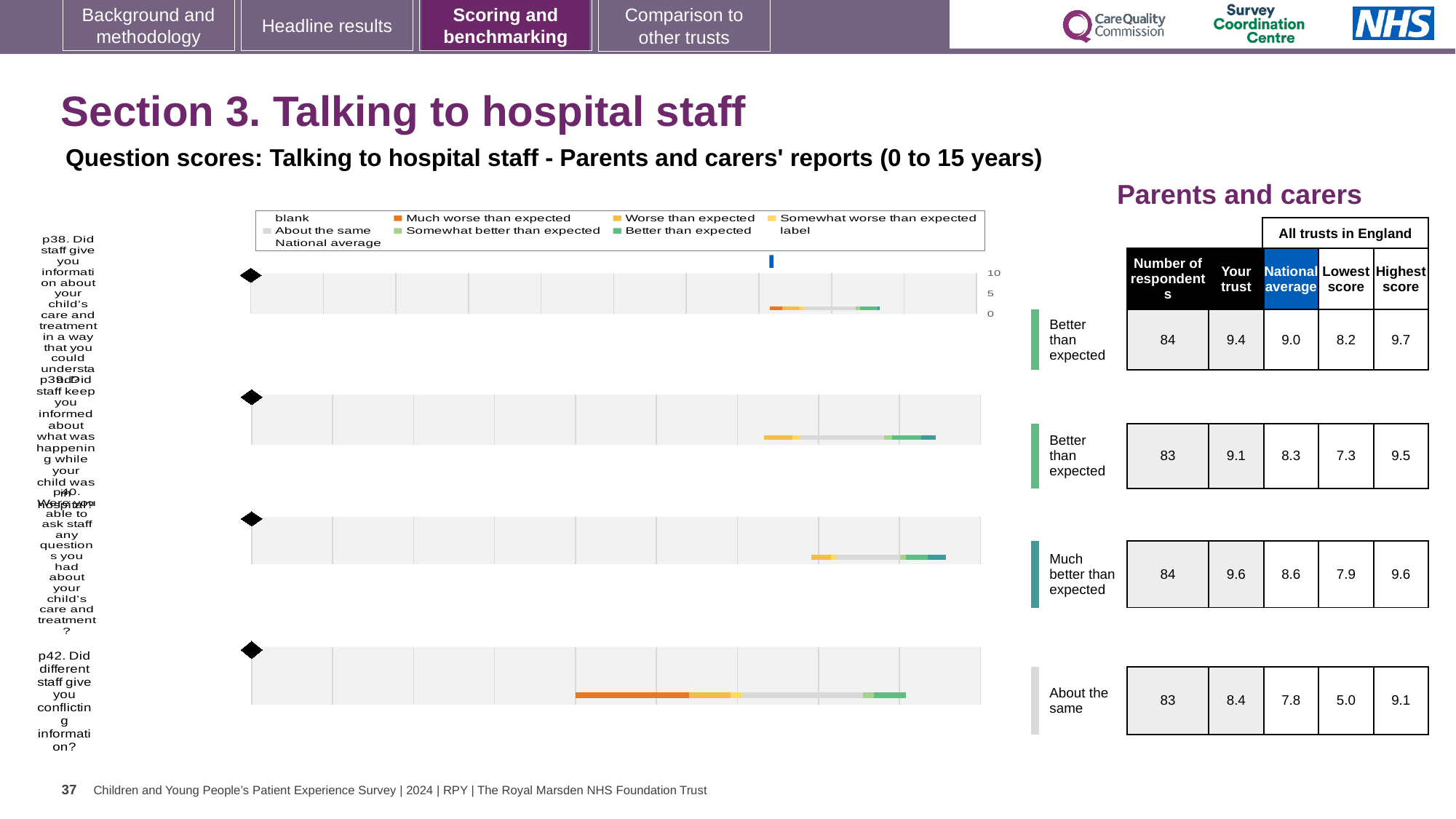
How many survey questions (p38, p39, p40, p42) have a benchmarking bar chart on this slide? 4 Which question has the lowest 'Your trust' score on this slide? p42 Which question has the highest 'Your trust' score on this slide? p40 For question p39, is the 'Your trust' score or the national average score larger? Your trust How many respondents answered question p40 (being able to ask staff any questions about your child's care and treatment)? 84 What is the lowest score among all trusts in England for question p42? 5.0 What kind of chart is used to show the benchmarking results for each question on this slide? bar chart What is the difference between the 'Your trust' score and the national average for question p40? 1.0 What is the 'Your trust' score for question p38 (staff giving information about your child's care and treatment in a way you could understand)? 9.4 What is the national average score for question p42 (different staff giving conflicting information)? 7.8 In the chart legend, which colour represents 'Much worse than expected'? orange What benchmarking category is shown for question p40? Much better than expected